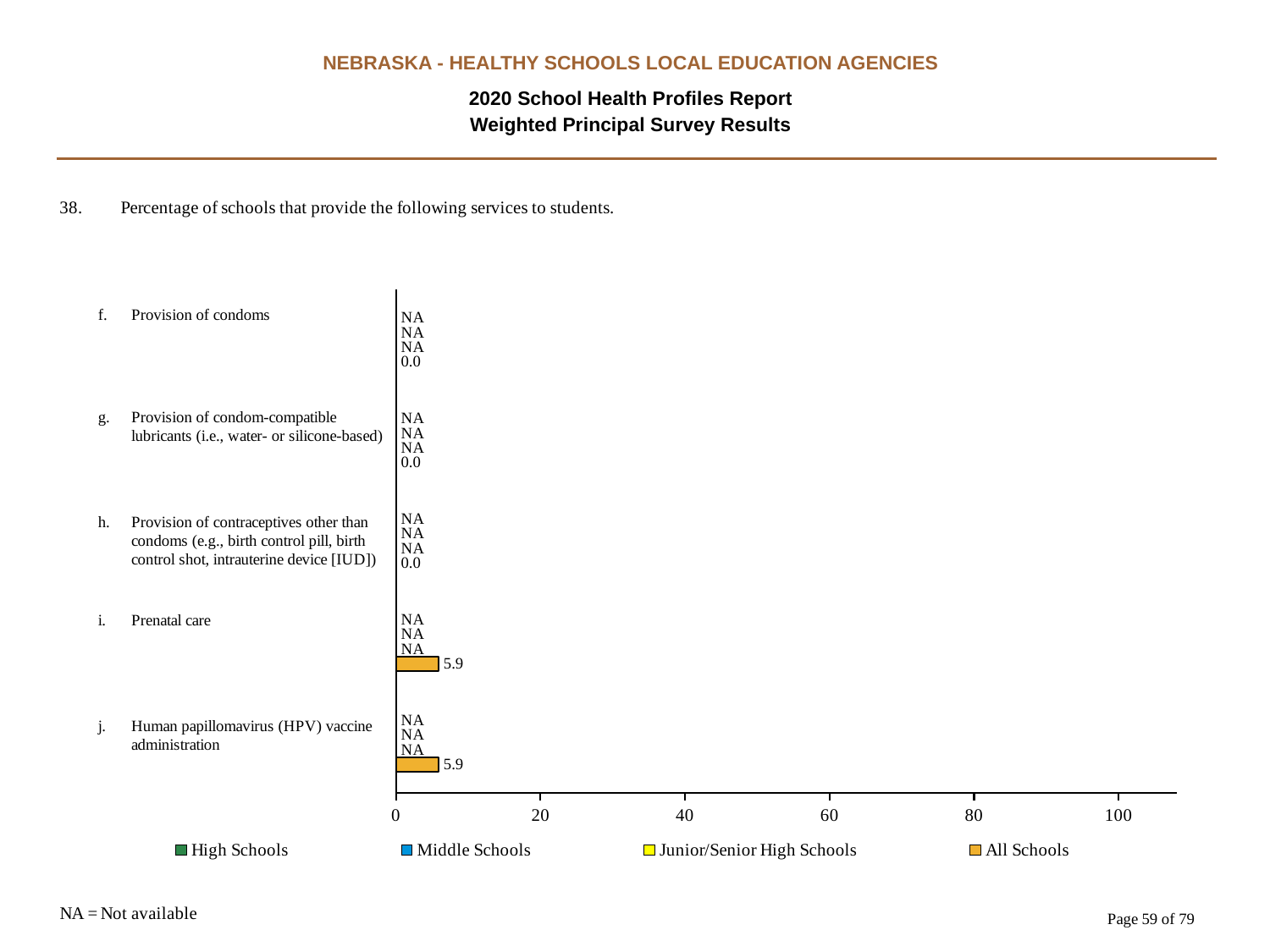
What does NA stand for according to the note on the slide? Not available Is the All Schools value for Prenatal care greater or less than 20? less How many service categories are shown on the chart? 5 What is the High Schools value shown for Provision of condom-compatible lubricants? NA What is the All Schools value for Provision of condoms? 0.0 What kind of chart is shown on the slide? bar chart What is the All Schools value for Human papillomavirus (HPV) vaccine administration? 5.9 What is the All Schools value for Prenatal care? 5.9 What is the All Schools value for Provision of contraceptives other than condoms? 0.0 How many series does the legend list? 4 What is the difference between the All Schools values for Prenatal care and Provision of condoms? 5.9 Which is larger, the All Schools value for HPV vaccine administration or for Provision of condoms? HPV vaccine administration